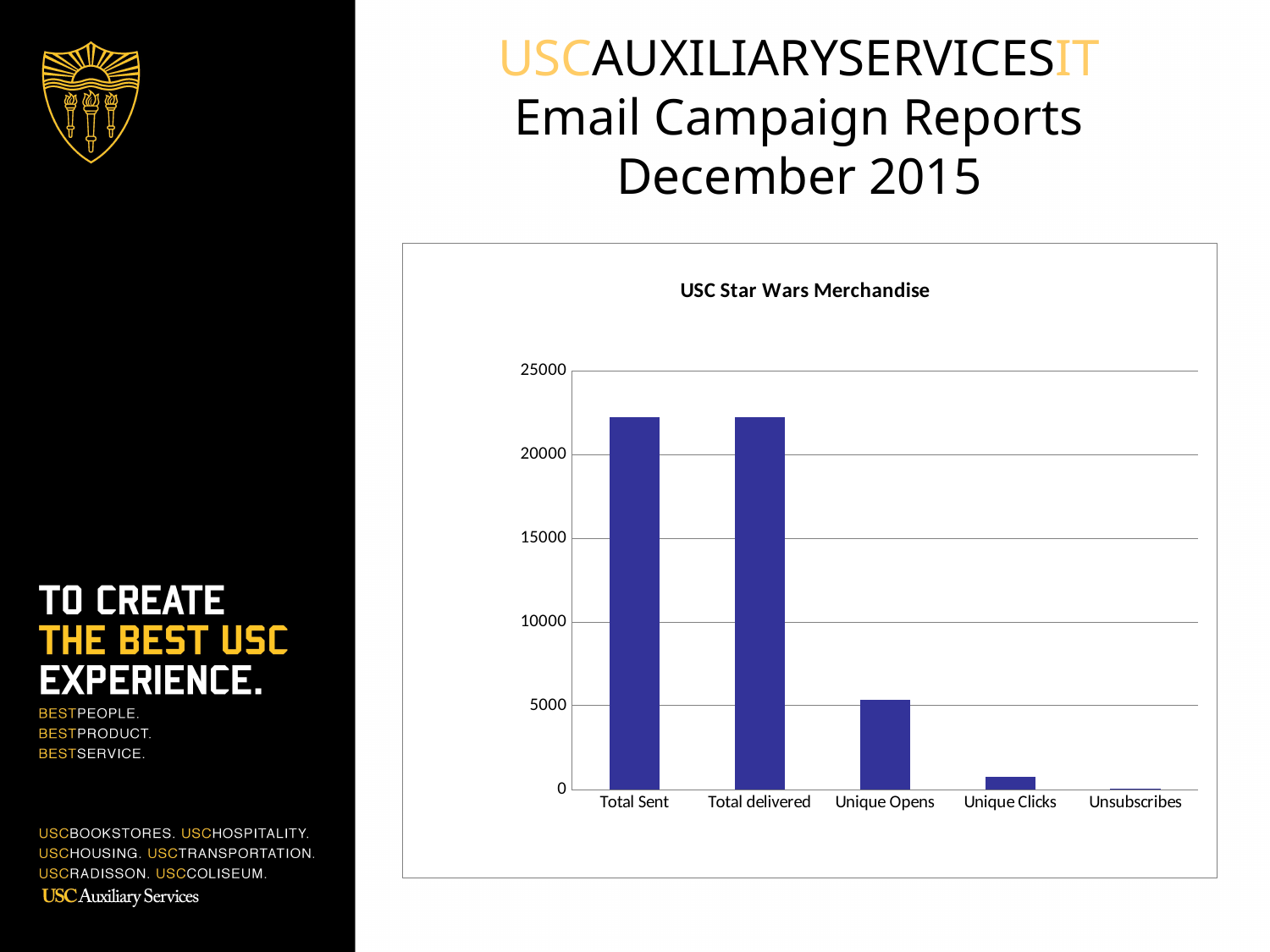
Which is larger, Total Sent or Unique Opens? Total Sent What is the title of the chart on the slide? USC Star Wars Merchandise Is the value for Unique Opens greater or less than 10000? less What is the highest value shown on the vertical axis of the chart? 25000 Do the values generally rise or fall moving from left to right across the categories? fall Is the value for Total delivered greater or less than 20000? greater What kind of chart is shown on the slide? bar chart Is the value for Unique Clicks greater or less than 5000? less Which is larger, Unique Opens or Unique Clicks? Unique Opens Which category has the lowest value in the USC Star Wars Merchandise chart? Unsubscribes How many categories are plotted in the USC Star Wars Merchandise chart? 5